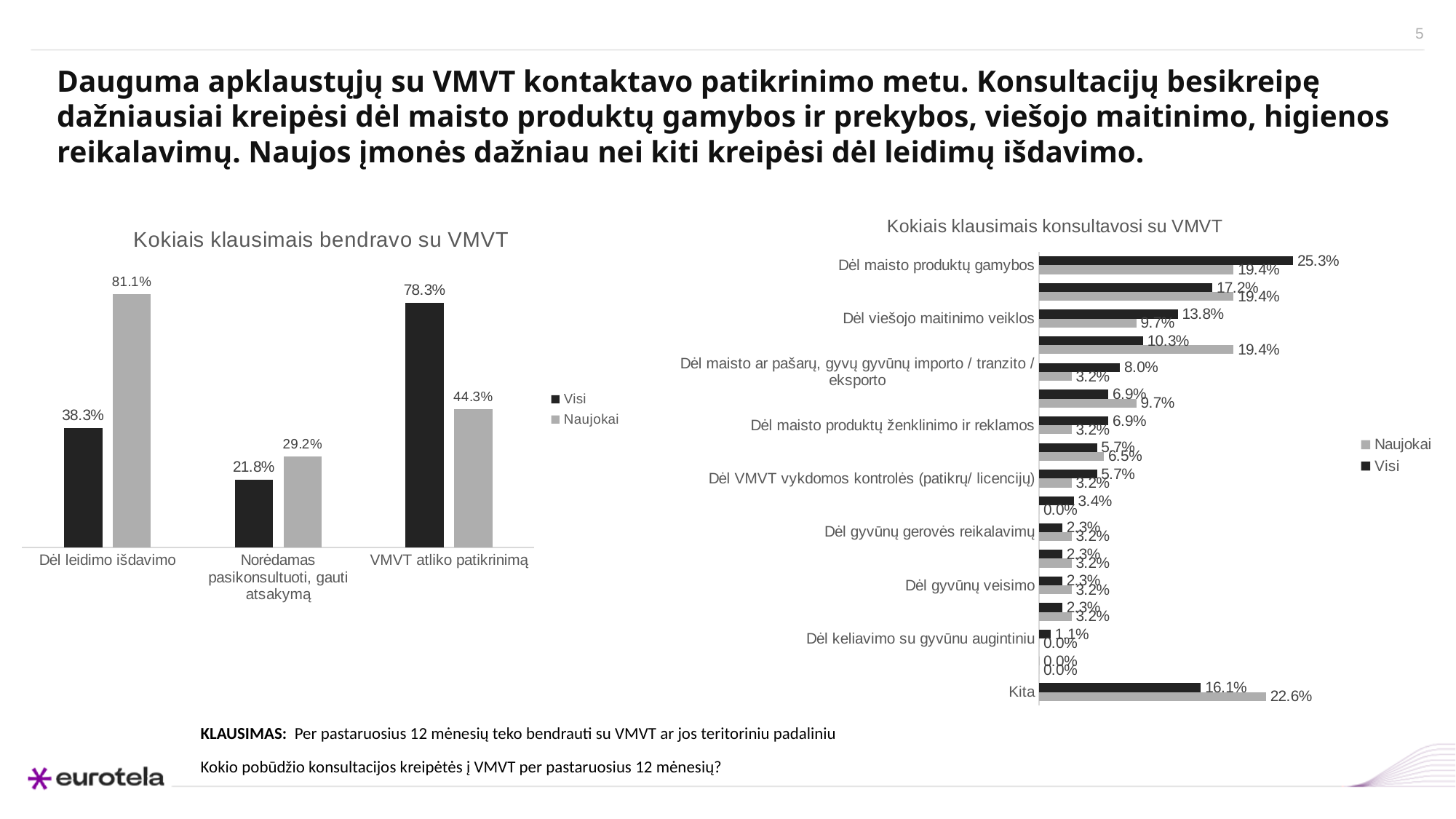
In the chart 'Kokiais klausimais konsultavosi su VMVT', what is the Visi value for 'Dėl maisto produktų gamybos'? 25.3% In the chart 'Kokiais klausimais bendravo su VMVT', how many categories are shown on the x axis? 3 In the chart 'Kokiais klausimais bendravo su VMVT', which category has the lowest Naujokai value? Norėdamas pasikonsultuoti, gauti atsakymą In the chart 'Kokiais klausimais bendravo su VMVT', what is the Naujokai value for 'Dėl leidimo išdavimo'? 81.1% In the chart 'Kokiais klausimais bendravo su VMVT', how many series does the legend list? 2 In the chart 'Kokiais klausimais bendravo su VMVT', what is the Visi value for 'VMVT atliko patikrinimą'? 78.3% In the chart 'Kokiais klausimais bendravo su VMVT', what is the difference between the Naujokai and Visi values for 'Dėl leidimo išdavimo'? 42.8% In the chart 'Kokiais klausimais konsultavosi su VMVT', which is larger for 'Dėl viešojo maitinimo veiklos': the Visi value or the Naujokai value? Visi In the chart 'Kokiais klausimais bendravo su VMVT', which category has the highest Visi value? VMVT atliko patikrinimą What type of chart is 'Kokiais klausimais konsultavosi su VMVT'? Bar chart In the chart 'Kokiais klausimais konsultavosi su VMVT', what is the difference between the Visi and Naujokai values for 'Dėl maisto ar pašarų, gyvų gyvūnų importo / tranzito / eksporto'? 4.8% In the chart 'Kokiais klausimais konsultavosi su VMVT', what is the Naujokai value for 'Kita'? 22.6%